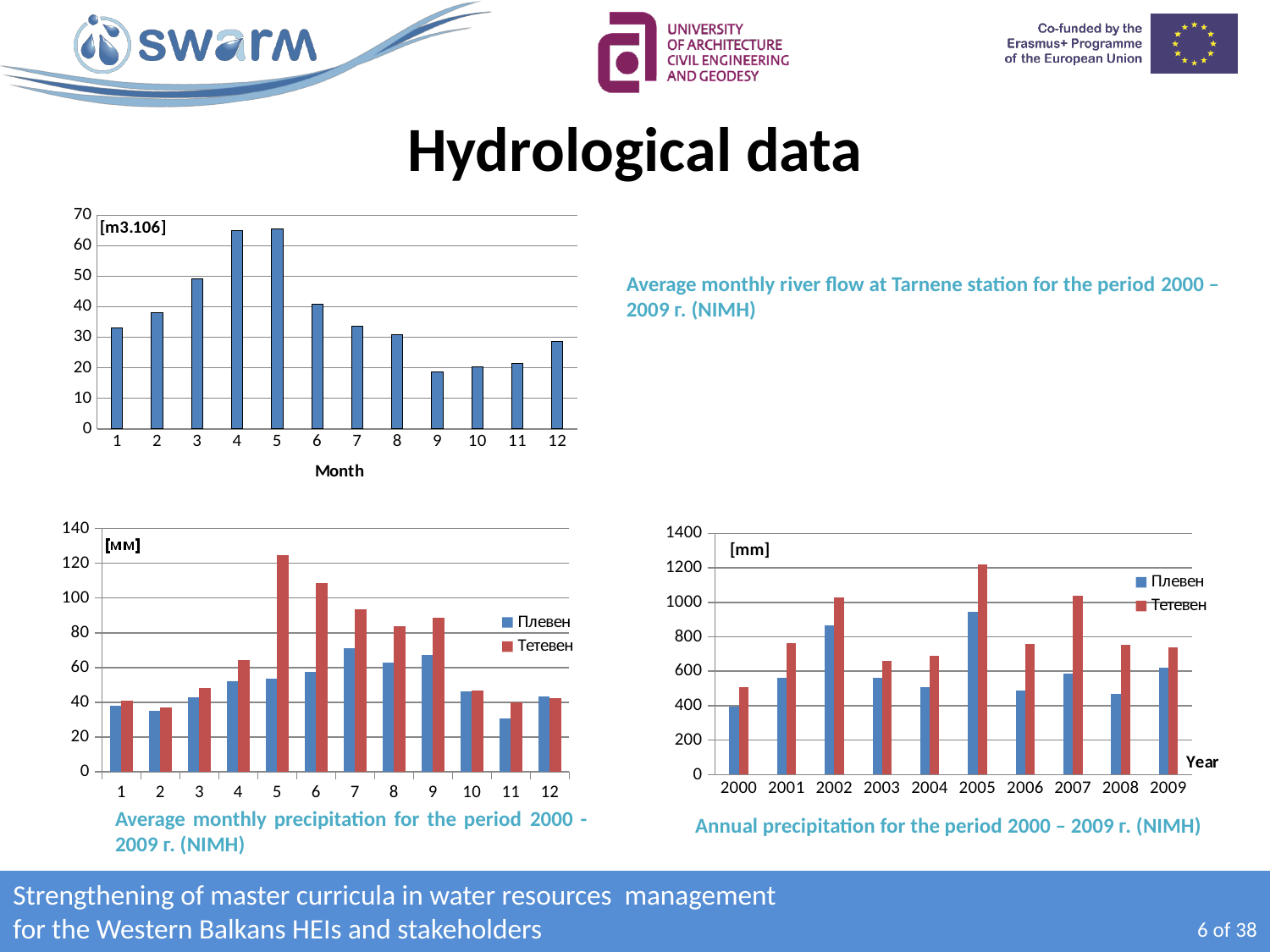
In the bottom-left average monthly precipitation chart, which month has the highest value for Тетевен? 5 In the bottom-right annual precipitation chart, which is larger in 2002, Плевен or Тетевен? Тетевен In the top-left river flow chart, which month has the lowest value? 9 What type of chart is the top-left chart showing average monthly river flow at Tarnene station? bar chart In the bottom-right annual precipitation chart, which year has the highest value for Тетевен? 2005 In the bottom-left average monthly precipitation chart, how many series does the legend list? 2 In the top-left river flow chart, is the value for month 1 greater or less than 30? greater In the top-left river flow chart, is the value for month 9 greater or less than 20? less In the bottom-left average monthly precipitation chart, is the value for Тетевен in month 5 greater or less than 120? greater In the bottom-left average monthly precipitation chart, which month has the lowest value for Плевен? 11 In the top-left river flow chart, which is larger, the value for month 3 or the value for month 7? month 3 In the top-left river flow chart, how many months are plotted on the x axis? 12